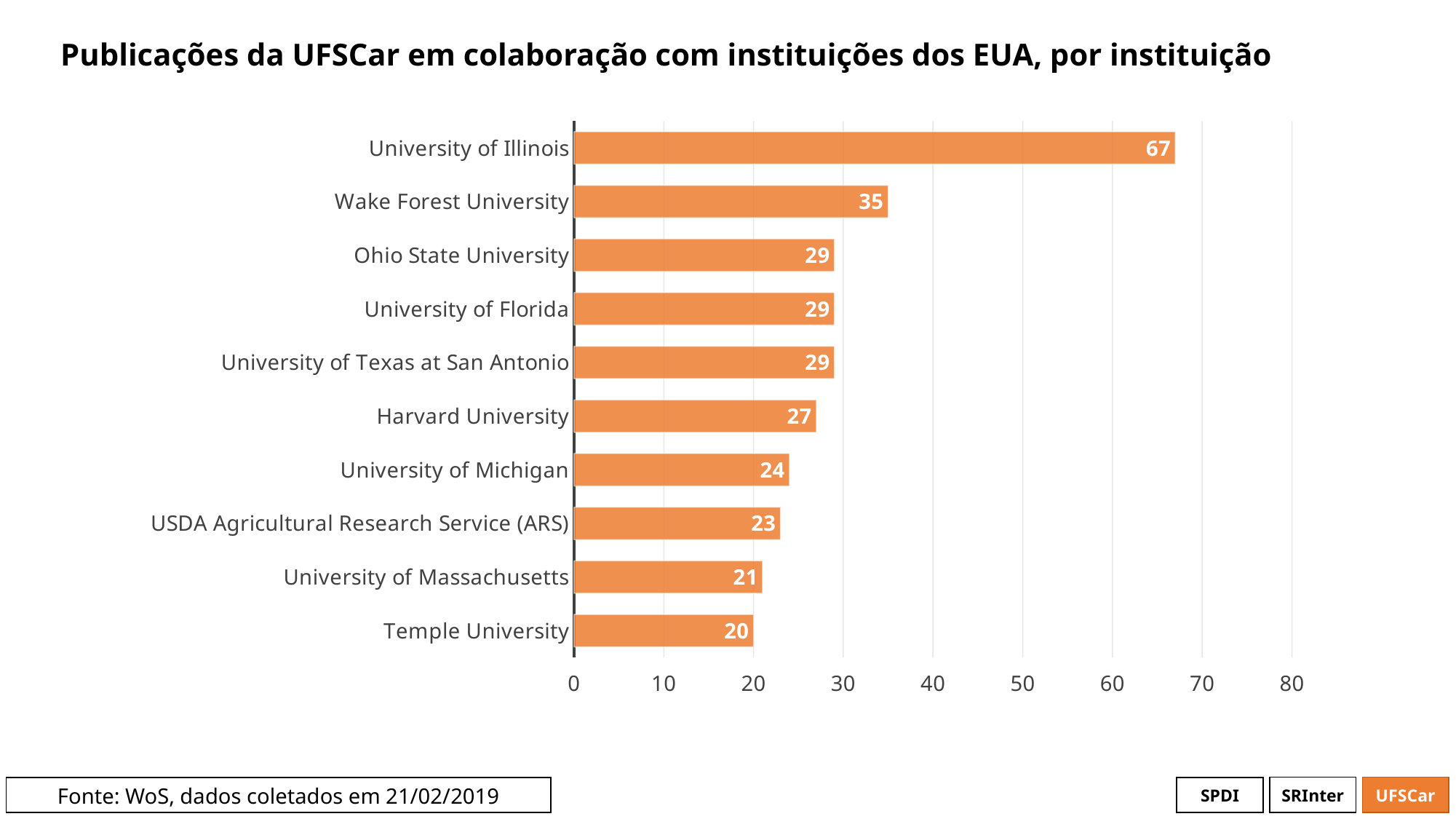
What is the value shown for Harvard University? 27 Which institution has the lowest number of publications? Temple University What is the difference between the values for University of Illinois and Wake Forest University? 32 Is the value for Ohio State University greater or less than 20? greater Which institution has the highest number of publications? University of Illinois What is the title of the chart? Publicações da UFSCar em colaboração com instituições dos EUA, por instituição What is the value shown for USDA Agricultural Research Service (ARS)? 23 What kind of chart is shown on the slide? Bar chart Which has a larger value, University of Michigan or University of Massachusetts? University of Michigan What is the value shown for Wake Forest University? 35 How many publications does the chart show for University of Illinois? 67 How many institutions are shown in the chart? 10